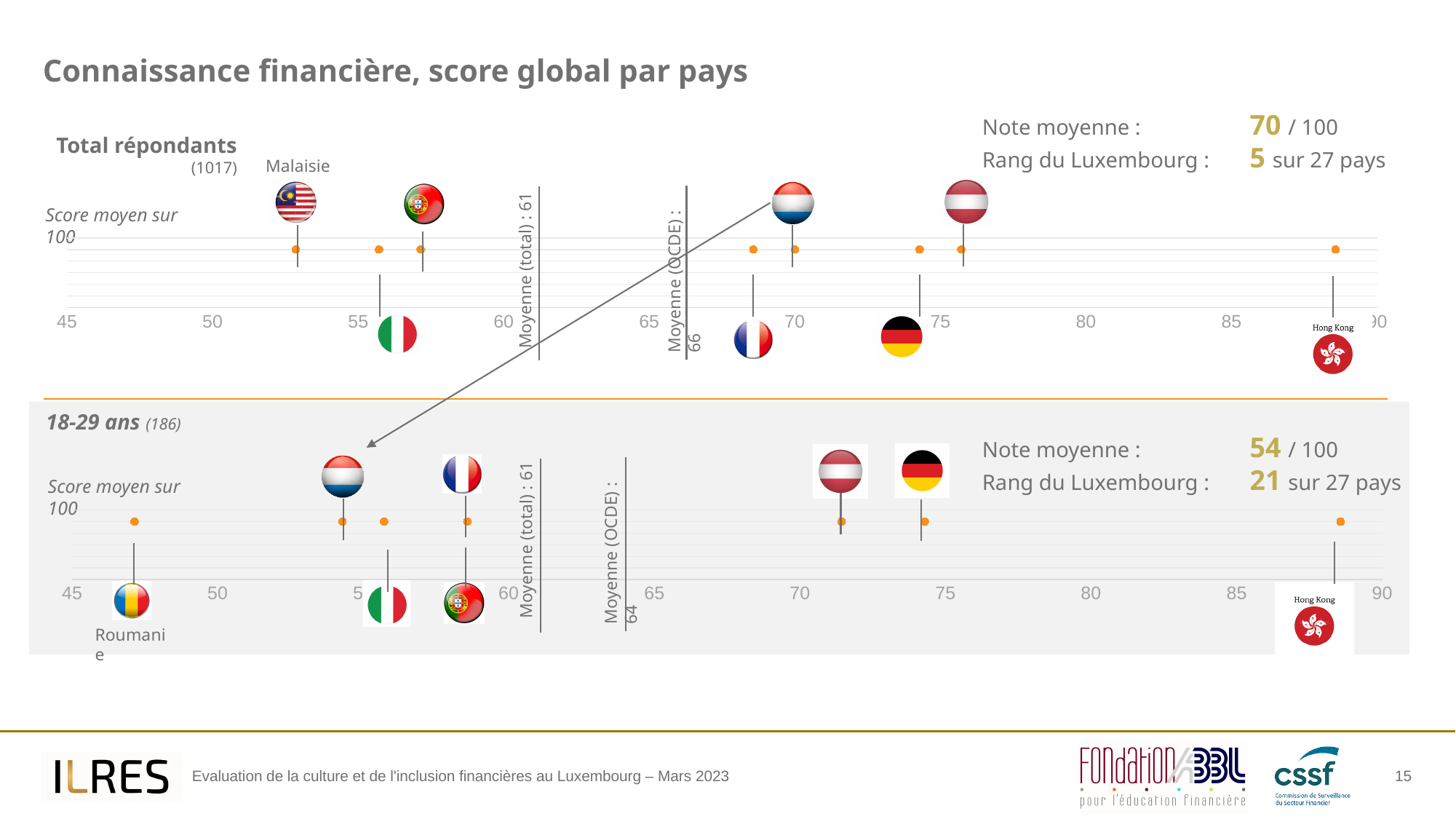
In the '18-29 ans' chart, what is the value of 'Moyenne (OCDE)'? 64 In the 'Total répondants' chart, what is the value of 'Moyenne (total)'? 61 In the 'Total répondants' chart, which has the higher score, Hong Kong or Malaisie? Hong Kong In the '18-29 ans' chart, is the value for Roumanie greater or less than 50? less In the '18-29 ans' chart, what is the 'Note moyenne' shown for Luxembourg? 54 / 100 In the 'Total répondants' chart, is the value for Hong Kong greater or less than 85? greater In the '18-29 ans' chart, what is the 'Rang du Luxembourg'? 21 sur 27 pays In the 'Total répondants' chart, what is the 'Rang du Luxembourg'? 5 sur 27 pays What is the difference between the 'Moyenne (OCDE)' in the 'Total répondants' chart and the 'Moyenne (OCDE)' in the '18-29 ans' chart? 2 In the 'Total répondants' chart, what is the value of 'Moyenne (OCDE)'? 66 In the 'Total répondants' chart, what is the 'Note moyenne' shown for Luxembourg? 70 / 100 In the 'Total répondants' chart, is the value for Malaisie greater or less than 55? less